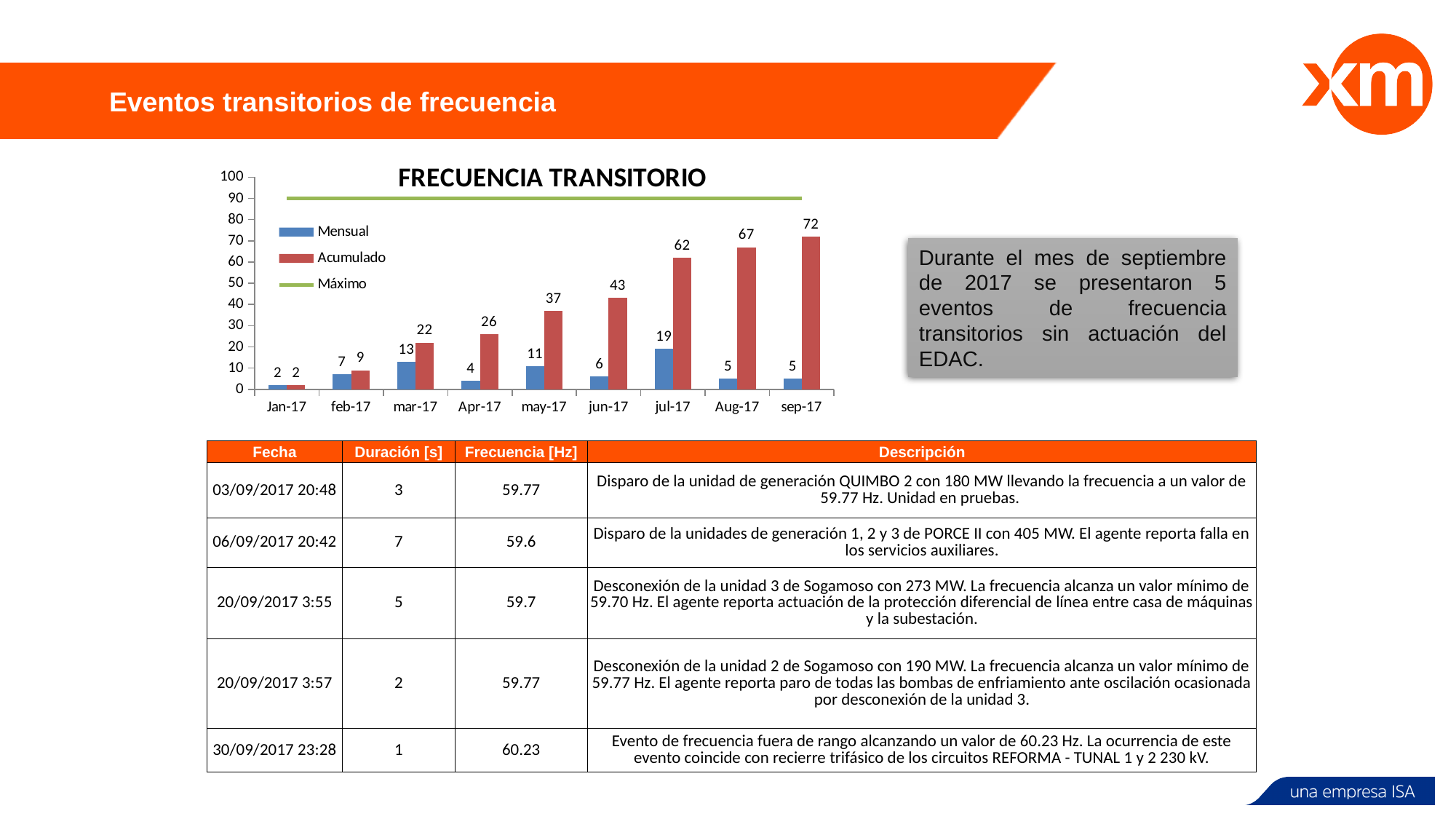
What is the difference between the Acumulado values for Aug-17 and jul-17? 5 How many months are shown on the x axis of the chart? 9 What kind of chart is used to show the Mensual and Acumulado values? bar chart Does the Acumulado series rise or fall from Jan-17 to sep-17? rise Which is larger, the Mensual value for mar-17 or the Mensual value for may-17? mar-17 How many entries does the chart legend list? 3 What is the Mensual value for jul-17? 19 Which month has the highest Mensual value? jul-17 What is the Acumulado value for sep-17? 72 Is the Acumulado value for jun-17 greater or less than 50? less What is the Acumulado value for may-17? 37 Which month has the lowest Mensual value? Jan-17